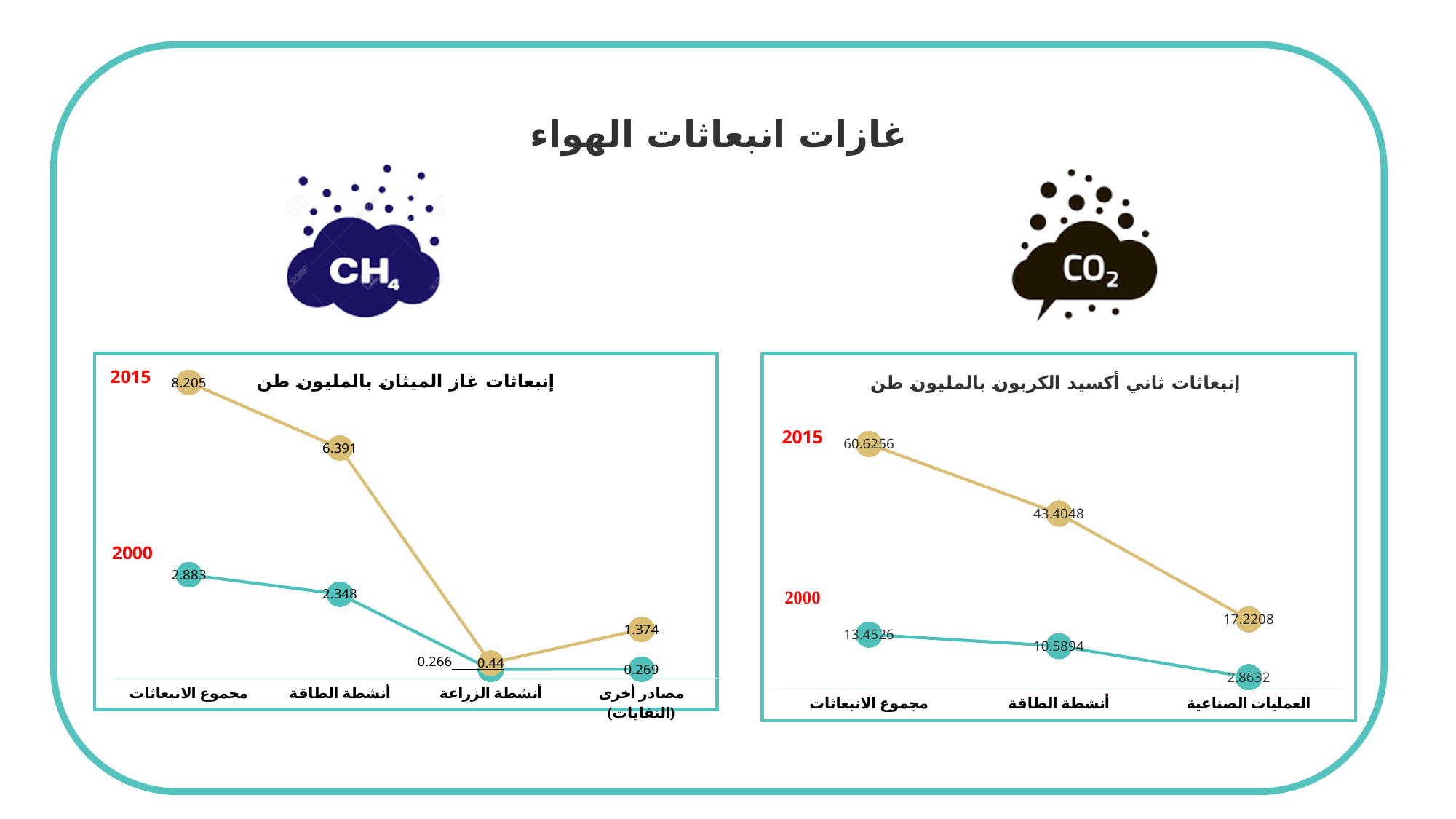
In the CO2 emissions chart (right), what is the 2000 value for العمليات الصناعية? 2.8632 In the methane emissions chart (left), what is the 2000 value for أنشطة الطاقة? 2.348 In the CO2 emissions chart (right), which category has the highest 2015 value? مجموع الانبعاثات In the methane emissions chart (left), what is the difference between the 2015 and 2000 values for مجموع الانبعاثات? 5.322 In the methane emissions chart (left), which is larger: the 2015 value for مصادر أخرى (النفايات) or the 2015 value for أنشطة الزراعة? مصادر أخرى (النفايات) What type of chart is the CO2 emissions chart (right)? line chart In the methane emissions chart (left), how many categories are shown on the x axis? 4 In the CO2 emissions chart (right), do the 2015 values rise or fall from left to right along the x axis? fall In the CO2 emissions chart (right), what is the difference between the 2015 and 2000 values for مجموع الانبعاثات? 47.173 In the methane emissions chart (left), what is the 2015 value for مجموع الانبعاثات? 8.205 In the methane emissions chart (left), which category has the lowest 2015 value? أنشطة الزراعة In the CO2 emissions chart (right), what is the 2015 value for أنشطة الطاقة? 43.4048